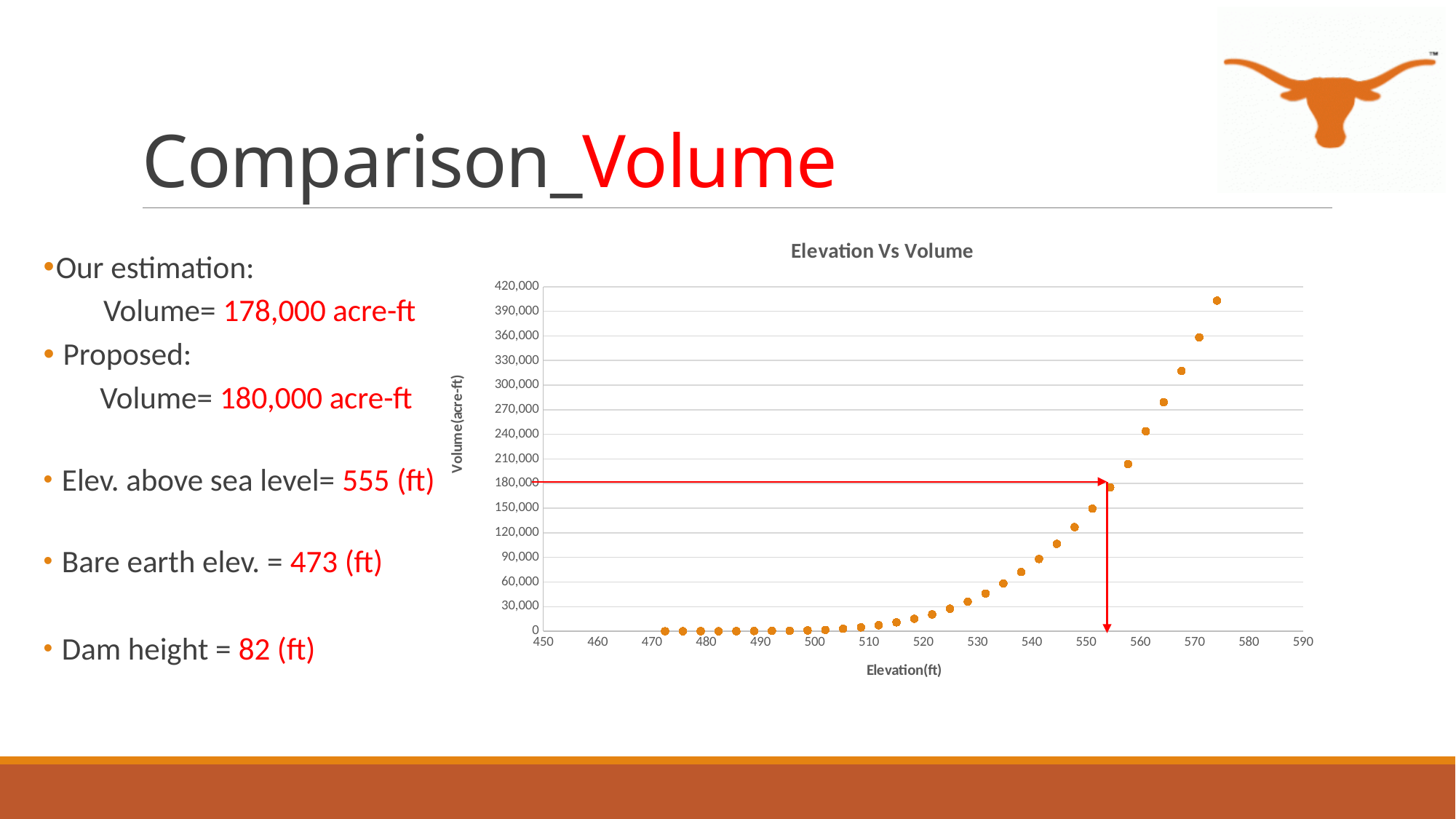
At which end of the elevation range is the volume highest, the low end near 470 ft or the high end near 575 ft? High end near 575 ft Is the volume at an elevation of about 570 ft greater or less than 330,000 acre-ft? greater Is the volume at an elevation of 480 ft greater or less than 30,000 acre-ft? less Is the volume at an elevation of about 540 ft greater or less than 60,000 acre-ft? greater What kind of chart is shown on the slide? Scatter chart Which has the larger volume: the point near 560 ft elevation or the point near 550 ft elevation? 560 ft Does the volume rise or fall as elevation increases along the x axis? Rises What is the title of the chart? Elevation Vs Volume What volume value on the y axis does the red horizontal arrow point to? 180,000